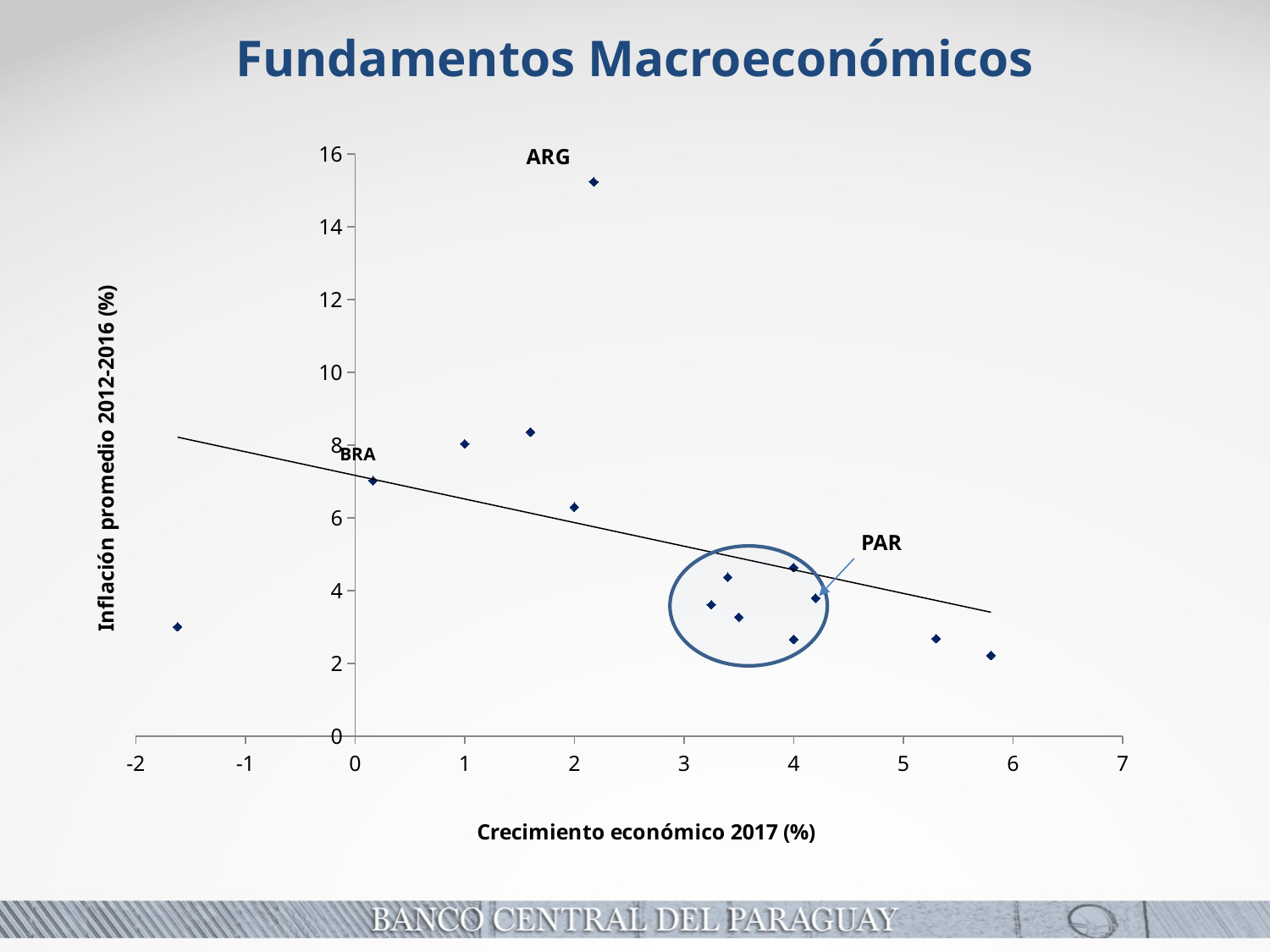
Which has higher economic growth 2017, PAR or BRA? PAR Is the economic growth 2017 for PAR greater or less than 3%? greater Among the labelled countries ARG, BRA and PAR, which has the lowest average inflation 2012-2016? PAR What is the title of the y axis? Inflación promedio 2012-2016 (%) Is the economic growth 2017 for BRA greater or less than 1%? less Which labelled country has the highest average inflation 2012-2016? ARG Does the fitted trend line rise or fall as economic growth 2017 increases? falls Is the average inflation 2012-2016 for ARG greater or less than 14%? greater What is the title of the x axis? Crecimiento económico 2017 (%) Which has higher average inflation 2012-2016, ARG or BRA? ARG What kind of chart is shown on the slide? scatter chart